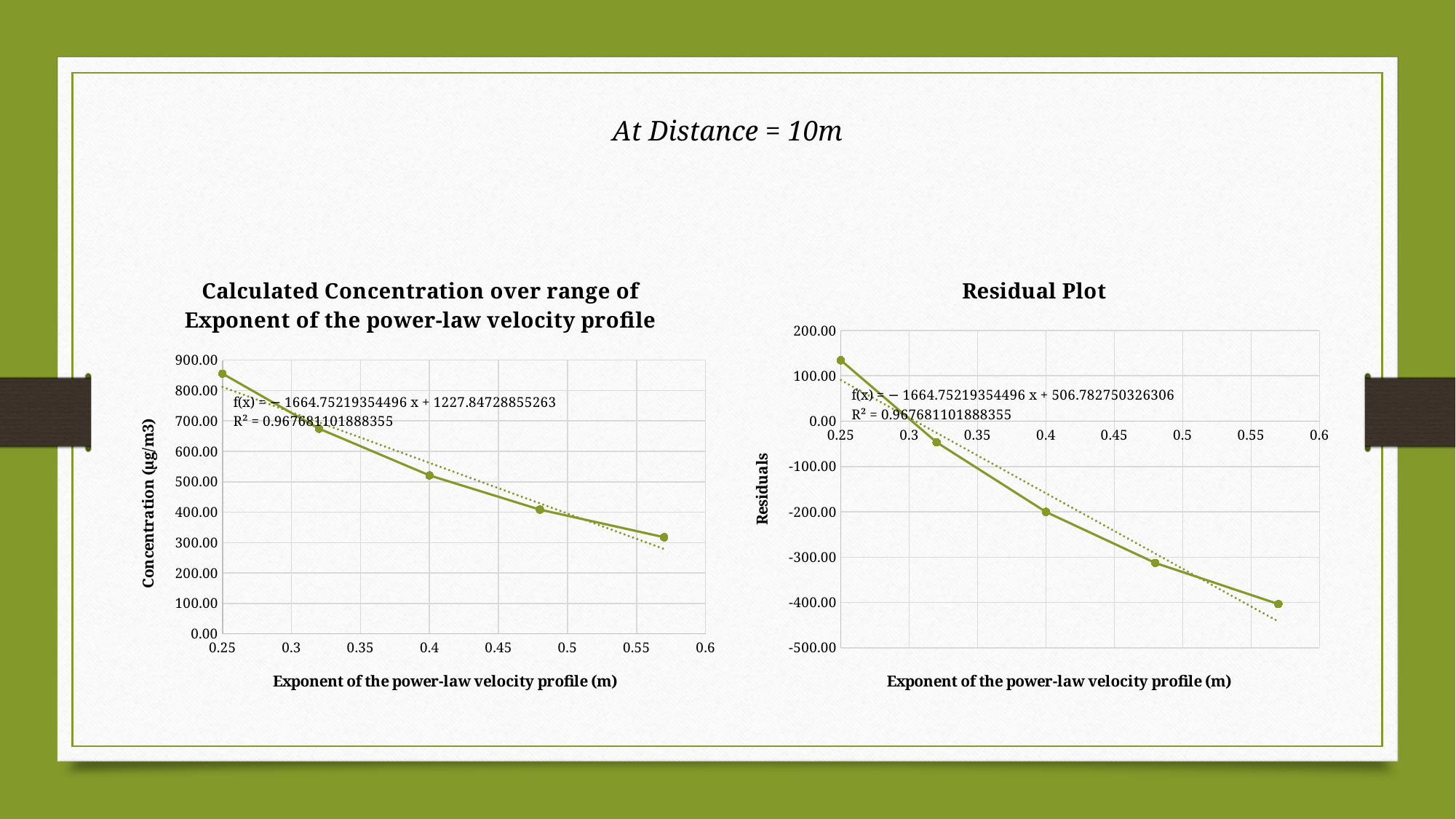
In the 'Calculated Concentration over range of Exponent of the power-law velocity profile' chart, is the concentration at the largest exponent plotted greater or less than 400? less In the 'Calculated Concentration over range of Exponent of the power-law velocity profile' chart, how many data points are plotted? 5 In the 'Residual Plot' chart, do the residuals rise or fall as the exponent increases? fall In the 'Residual Plot' chart, is the residual at exponent 0.4 greater or less than -100? less What R² value is shown on the 'Residual Plot' chart? 0.967681101888355 In the 'Calculated Concentration over range of Exponent of the power-law velocity profile' chart, do the values rise or fall as the exponent increases? fall What kind of chart is the 'Residual Plot' chart? line chart In the 'Calculated Concentration over range of Exponent of the power-law velocity profile' chart, is the concentration at exponent 0.25 greater or less than 800? greater In the 'Residual Plot' chart, which plotted point has the lowest residual: the one at exponent 0.25 or the one at the largest exponent? the one at the largest exponent What is the x-axis label of the 'Calculated Concentration over range of Exponent of the power-law velocity profile' chart? Exponent of the power-law velocity profile (m) In the 'Residual Plot' chart, how many data points are plotted? 5